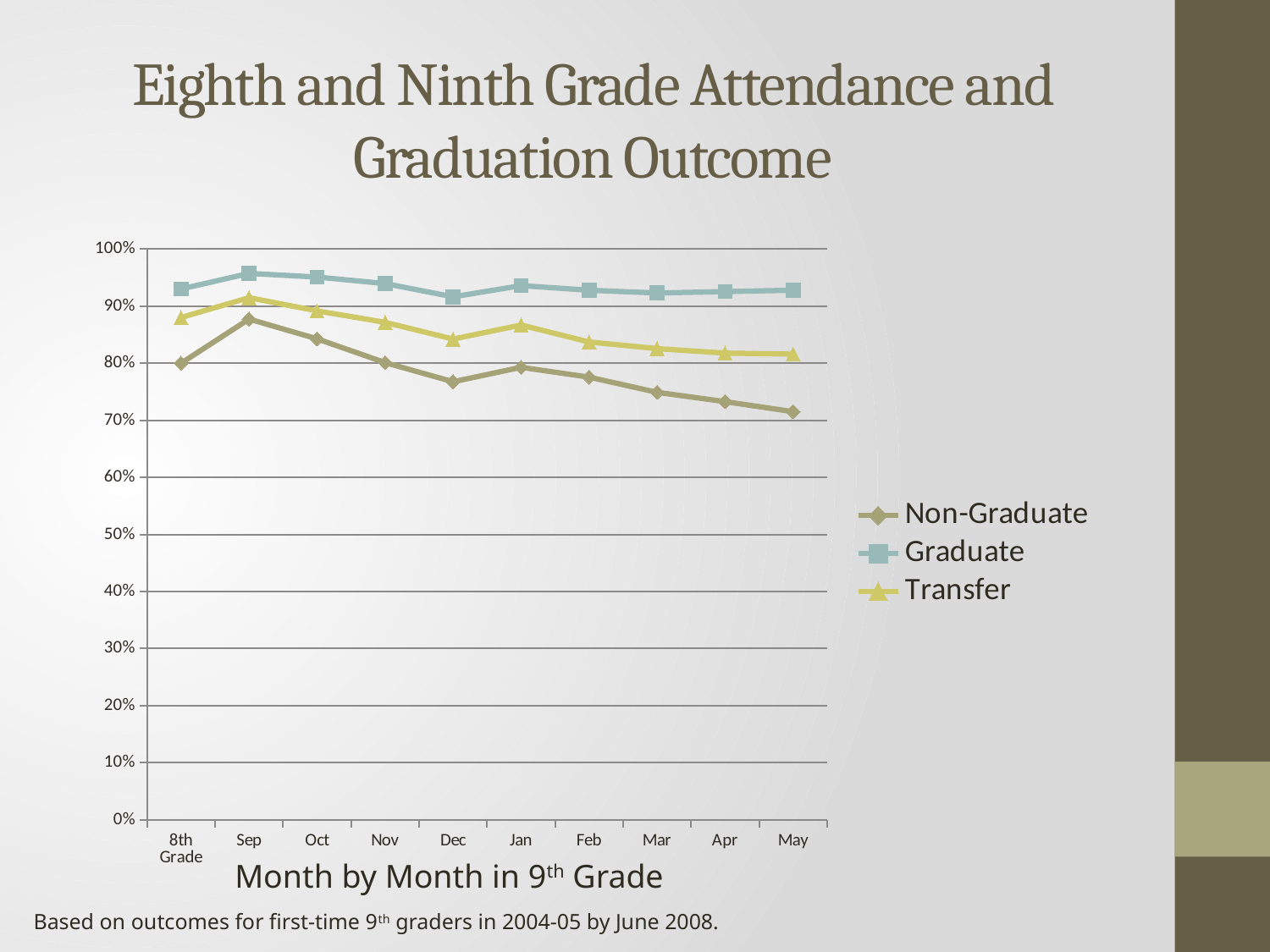
Does the Non-Graduate series rise or fall from Sep to May? fall Is the Graduate value for Sep greater or less than 90%? greater What is the title of the x axis? Month by Month in 9th Grade At which x-axis point does the Graduate series reach its highest value? Sep At which x-axis point does the Non-Graduate series reach its lowest value? May How many series does the legend list? 3 Is the Non-Graduate value for May greater or less than 80%? less Is the Transfer value for Dec greater or less than 90%? less Which series has the lowest values across the chart? Non-Graduate What kind of chart is shown on the slide? line chart How many points are plotted along the x axis for each series? 10 Which series has the highest values across the chart? Graduate